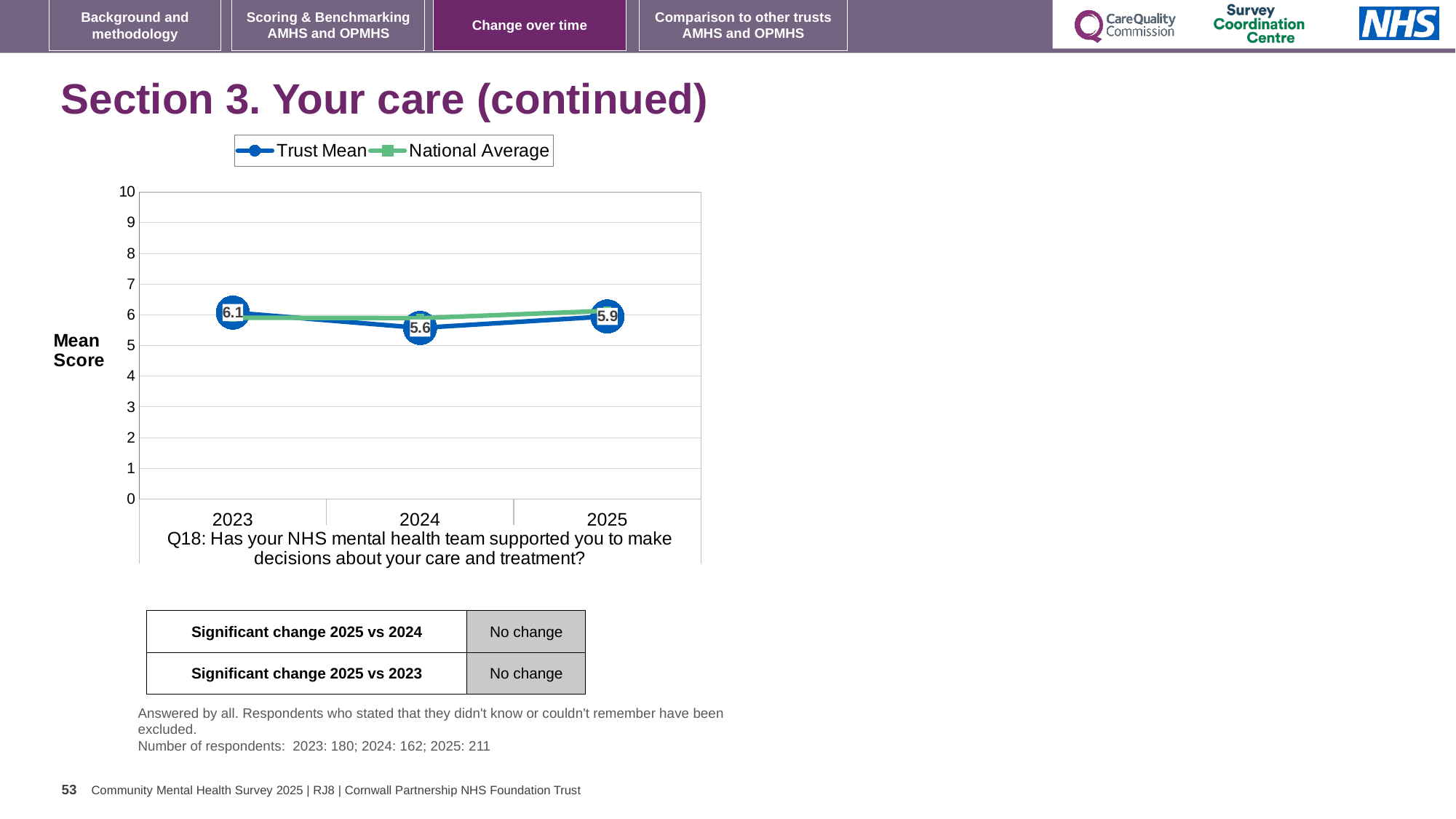
In 2024, which is higher, the Trust Mean or the National Average? National Average In which year is the Trust Mean score lowest? 2024 How many series does the chart legend list? 2 How many years are shown on the x axis of the chart? 3 What is the Trust Mean score for 2024? 5.6 Which is larger, the Trust Mean score for 2025 or for 2024? 2025 What is the difference between the Trust Mean scores for 2023 and 2024? 0.5 Is the National Average value for 2025 greater or less than 5? greater What is the Trust Mean score for 2025? 5.9 What is the Trust Mean score for 2023? 6.1 What kind of chart is shown on the slide? Line chart In which year is the Trust Mean score highest? 2023